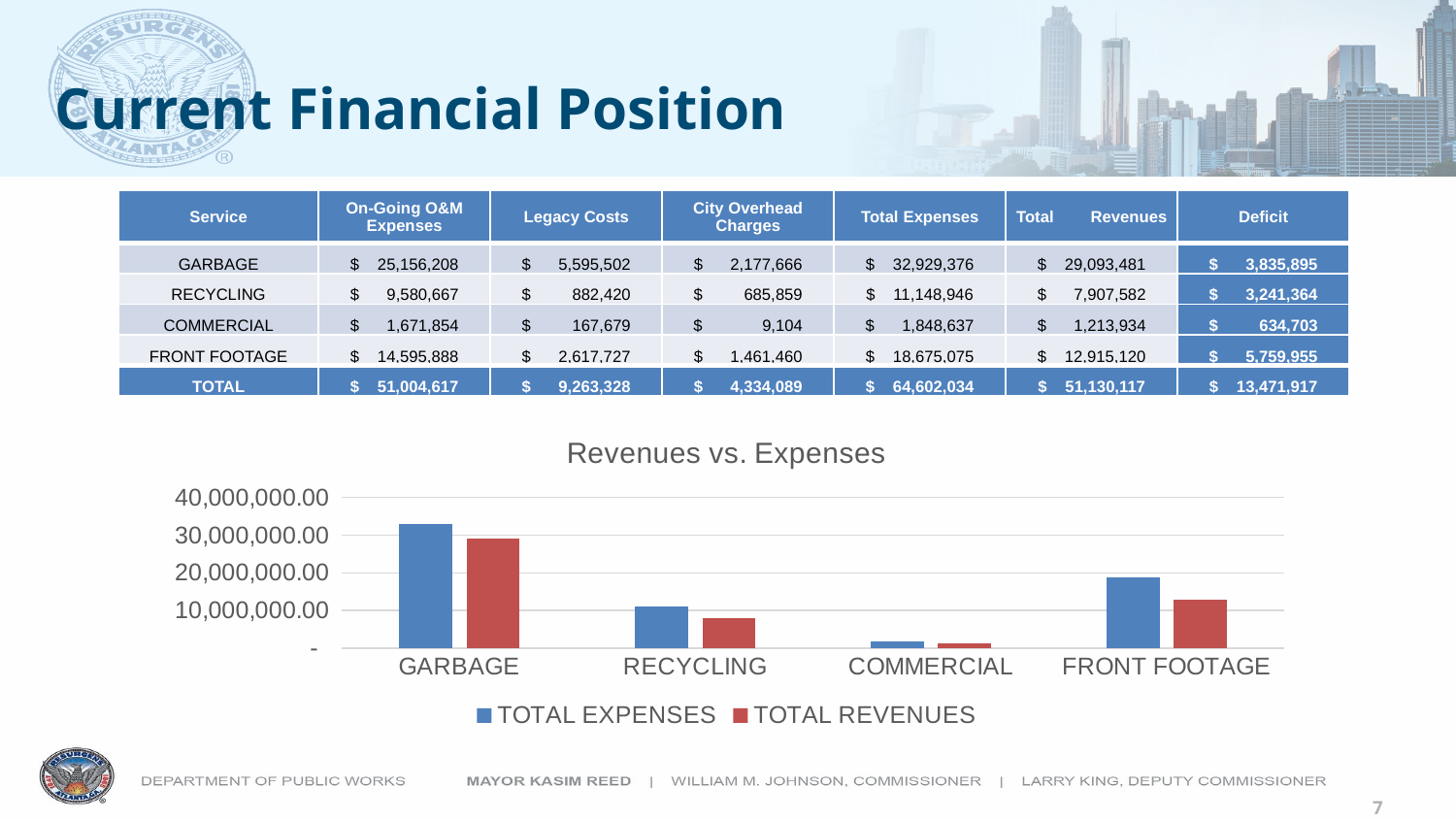
What is the title of the chart? Revenues vs. Expenses What kind of chart is shown on the slide? bar chart For RECYCLING, which is larger: TOTAL EXPENSES or TOTAL REVENUES? TOTAL EXPENSES Is the TOTAL REVENUES value for RECYCLING greater or less than 10,000,000.00? less Which series is shown in red in the chart? TOTAL REVENUES How many series does the chart legend list? 2 Is the TOTAL EXPENSES value for FRONT FOOTAGE greater or less than 20,000,000.00? less Which category has the highest TOTAL EXPENSES in the chart? GARBAGE Which category has the lowest TOTAL REVENUES in the chart? COMMERCIAL How many service categories are shown on the x axis of the chart? 4 Is the TOTAL REVENUES value for FRONT FOOTAGE greater or less than 10,000,000.00? greater